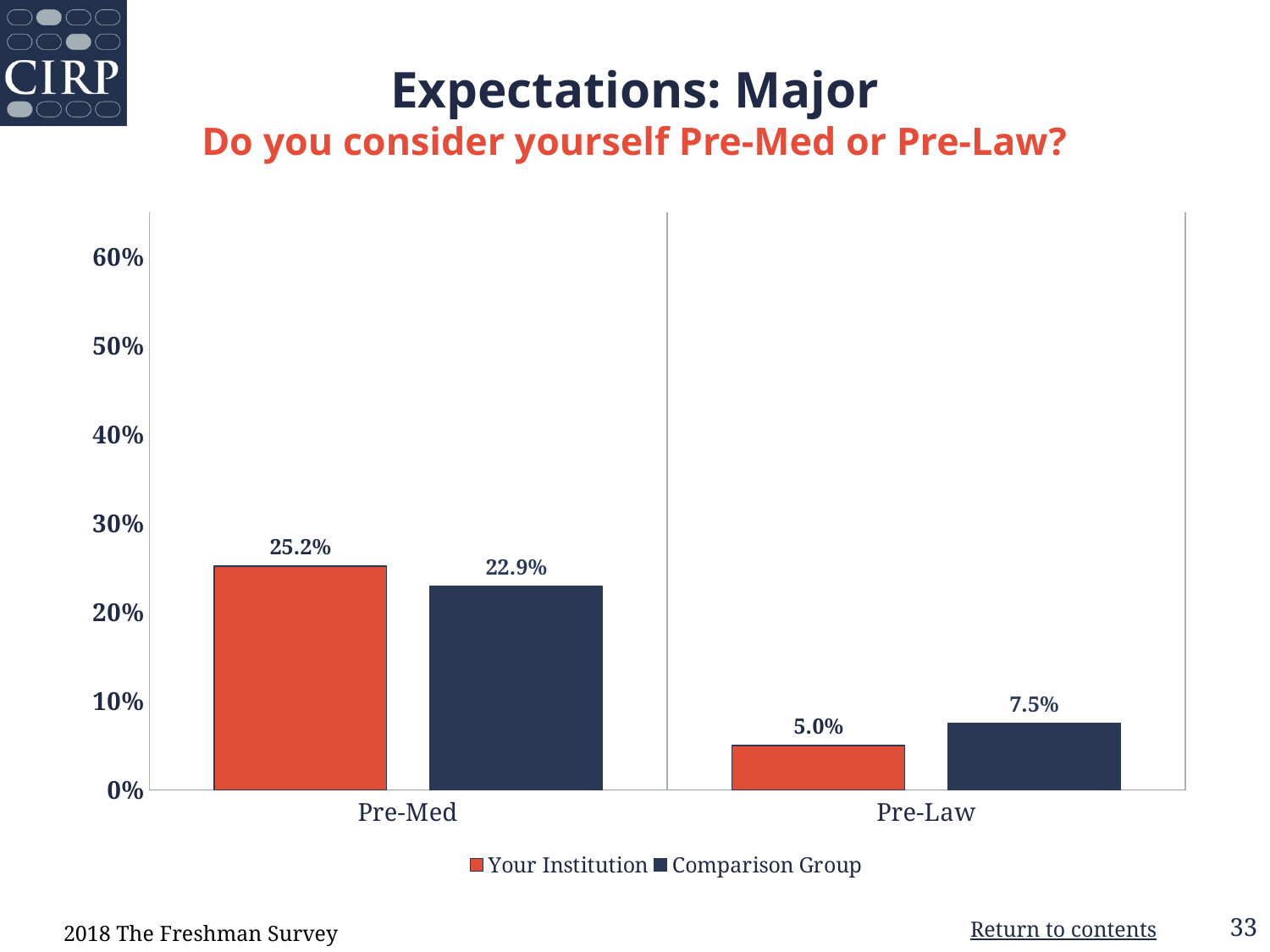
Which bar in the chart has the lowest value? Your Institution, Pre-Law How many categories are shown on the x axis? 2 For Pre-Law, which is larger: Your Institution or the Comparison Group? Comparison Group What is the Comparison Group value for Pre-Law? 7.5% How many series does the legend list? 2 What is the Your Institution value for Pre-Law? 5.0% What is the difference between Your Institution and the Comparison Group for Pre-Med? 2.3% What is the Comparison Group value for Pre-Med? 22.9% What is the difference between the Comparison Group and Your Institution for Pre-Law? 2.5% Which bar in the chart has the highest value? Your Institution, Pre-Med What percentage of Your Institution students consider themselves Pre-Med? 25.2% What type of chart is shown on the slide? Bar chart